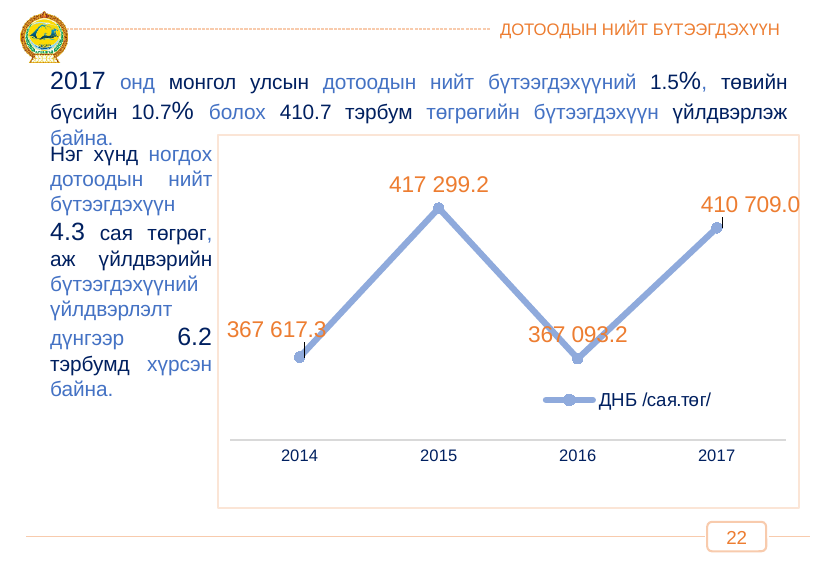
How many years are plotted in the chart? 4 What is the value for 2015 in the ДНБ /сая.төг/ chart? 417 299.2 What is the value for 2016 in the chart? 367 093.2 What kind of chart is shown on the slide? Line chart What is the value for 2017 in the chart? 410 709.0 What is the difference between the 2015 and 2014 values? 49 681.9 Which year has the lowest value in the chart? 2016 What is the value for 2014 in the chart? 367 617.3 How many series does the legend list? 1 Which year has the highest value in the chart? 2015 What is the difference between the 2017 and 2016 values? 43 615.8 Which is larger, the value for 2015 or the value for 2017? 2015